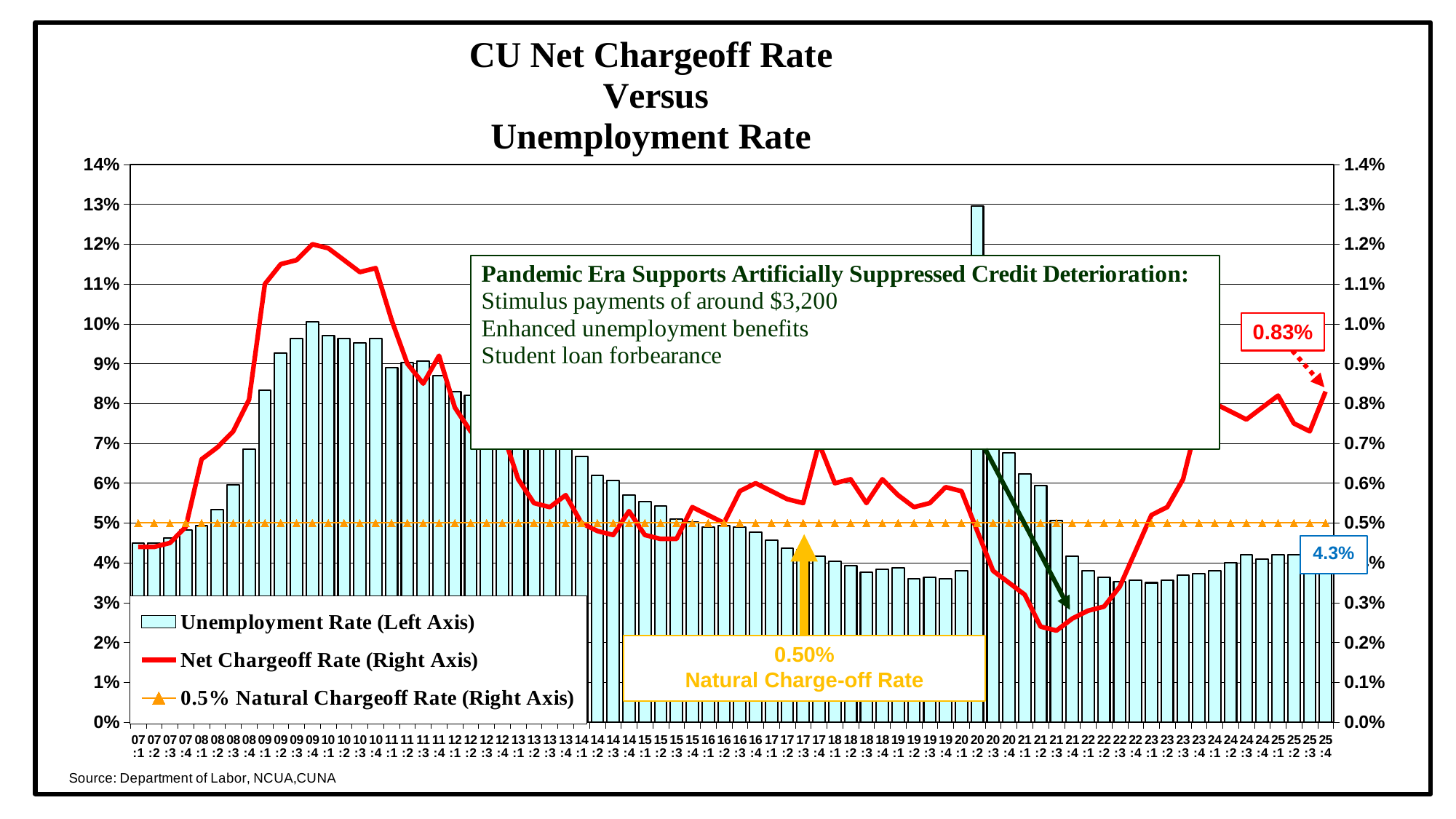
On which axis is the Unemployment Rate plotted? Left axis What is the Unemployment Rate labelled at the end of the series (25:4)? 4.3% What value is the Natural Charge-off Rate line set at? 0.50% In which quarter is the Unemployment Rate bar highest? 20:2 Does the Net Chargeoff Rate rise or fall from 21:3 to 23:4? rise Which quarter has the larger Unemployment Rate, 09:4 or 19:4? 09:4 Is the Net Chargeoff Rate in 09:4 greater or less than 1.0%? greater What is the Net Chargeoff Rate labelled at the end of the series (25:4)? 0.83% Is the Unemployment Rate in 20:2 greater or less than 12%? greater Is the Net Chargeoff Rate in 21:3 greater or less than 0.3%? less What kind of chart is shown on the slide? A combined bar and line chart How many series does the legend list? 3